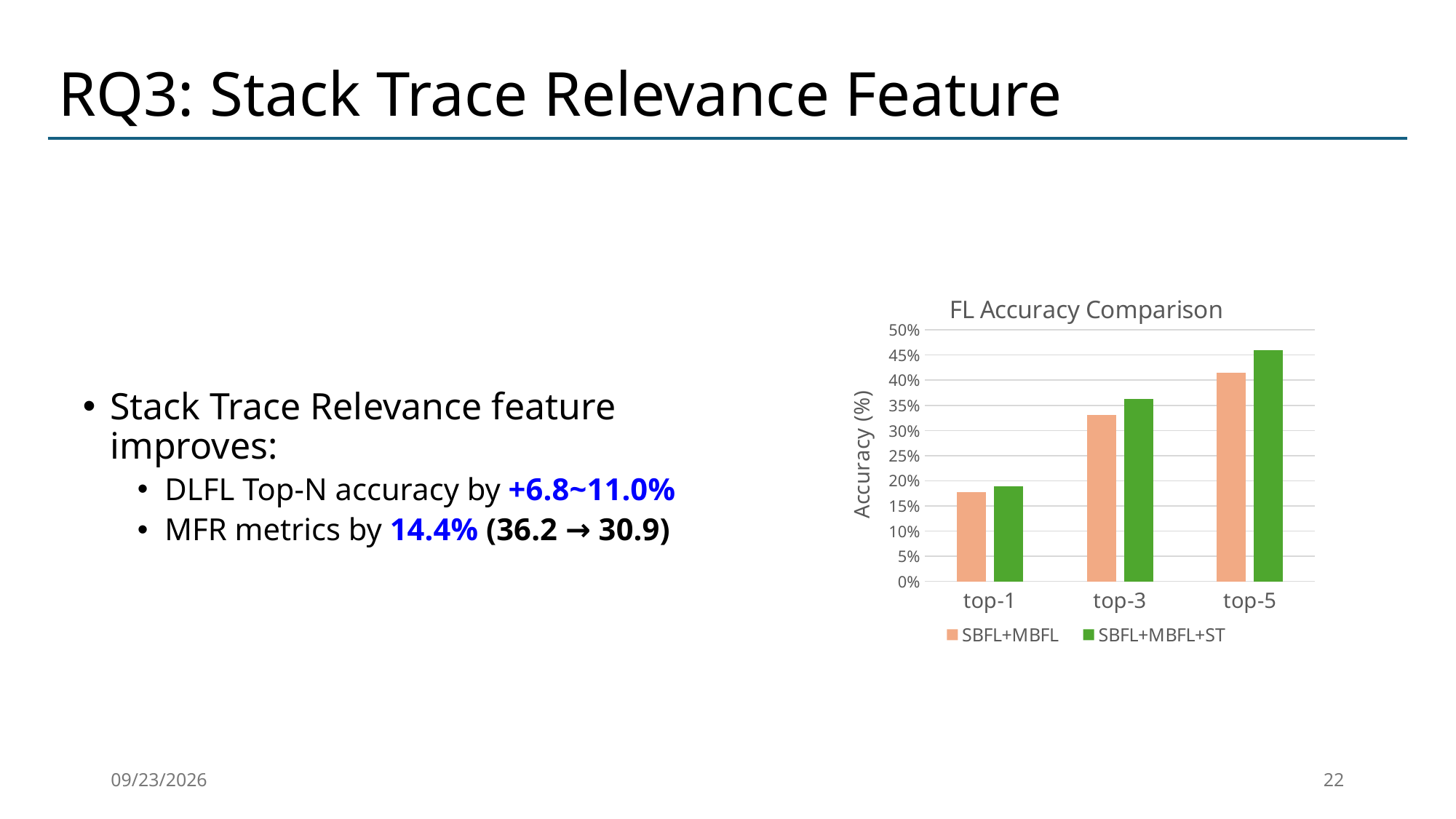
Is the accuracy for SBFL+MBFL at top-1 greater or less than 20%? less Which category has the lowest accuracy for the SBFL+MBFL series? top-1 How many categories are shown on the x axis of the chart? 3 Is the accuracy for SBFL+MBFL at top-3 greater or less than 30%? greater For top-5, which series has the larger accuracy, SBFL+MBFL or SBFL+MBFL+ST? SBFL+MBFL+ST How many series does the chart legend list? 2 What type of chart is shown on the slide? bar chart Which category has the highest accuracy for the SBFL+MBFL+ST series? top-5 Is the accuracy for SBFL+MBFL+ST at top-5 greater or less than 40%? greater What is the label of the y axis of the chart? Accuracy (%) What is the title of the chart? FL Accuracy Comparison Do the accuracy values for SBFL+MBFL+ST rise or fall from top-1 to top-5? rise